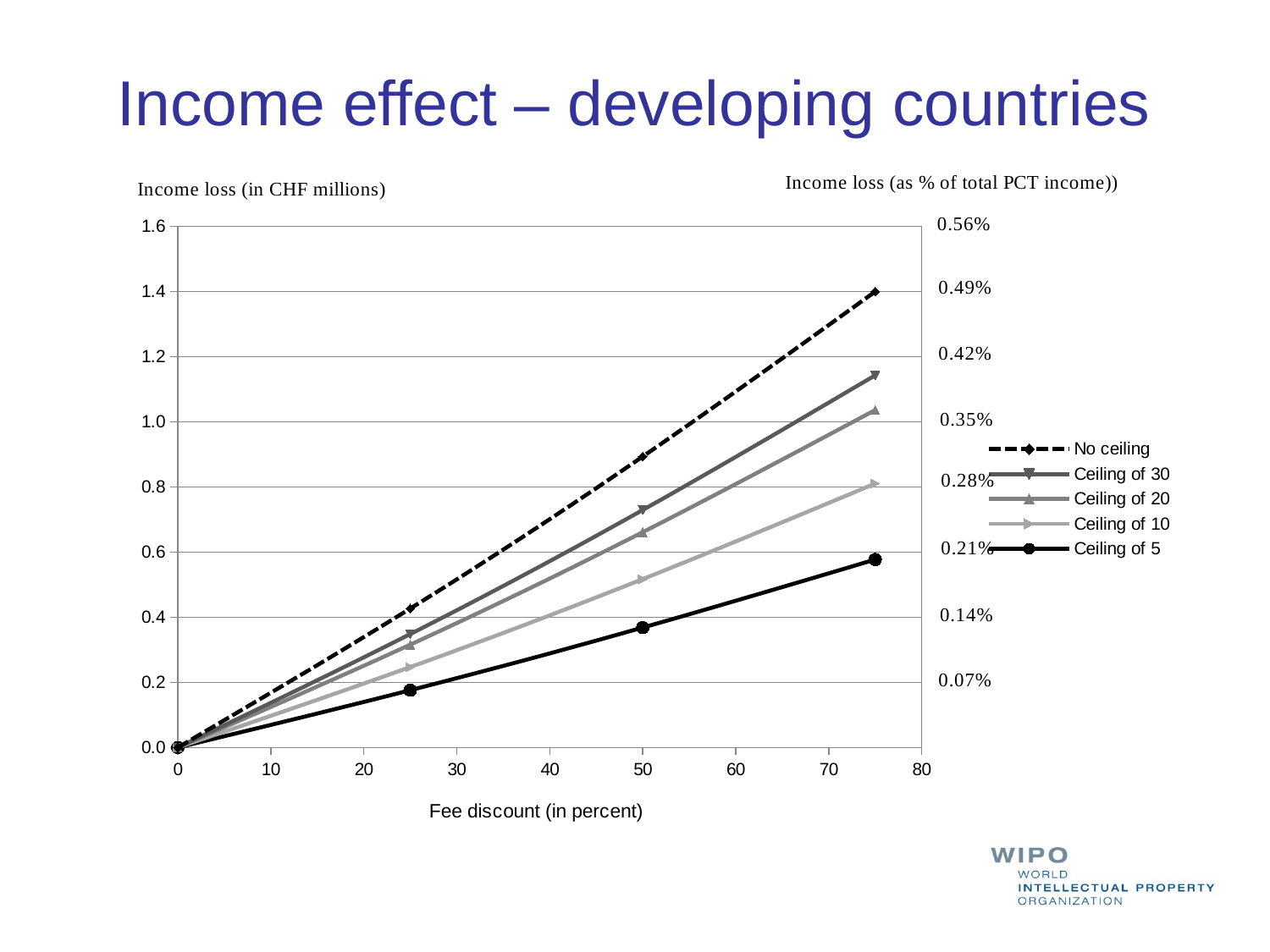
Do the income loss values rise or fall as the fee discount increases? rise Is the income loss (in CHF millions) for the No ceiling series at a 50 percent fee discount greater or less than 0.8? greater Which series has the highest income loss at a fee discount of 75 percent? No ceiling How many data points are plotted for each series along the x axis? 4 Which series has the lowest income loss at a fee discount of 75 percent? Ceiling of 5 How many series does the legend list? 5 What kind of chart is shown on the slide? line chart Is the income loss (in CHF millions) for the Ceiling of 20 series at a 50 percent fee discount greater or less than 0.6? greater At a fee discount of 75 percent, which series shows a larger income loss: Ceiling of 30 or Ceiling of 20? Ceiling of 30 Is the income loss (in CHF millions) for the Ceiling of 10 series at a 75 percent fee discount greater or less than 1.0? less What is the title of the x axis? Fee discount (in percent) What is the label of the left vertical axis? Income loss (in CHF millions)